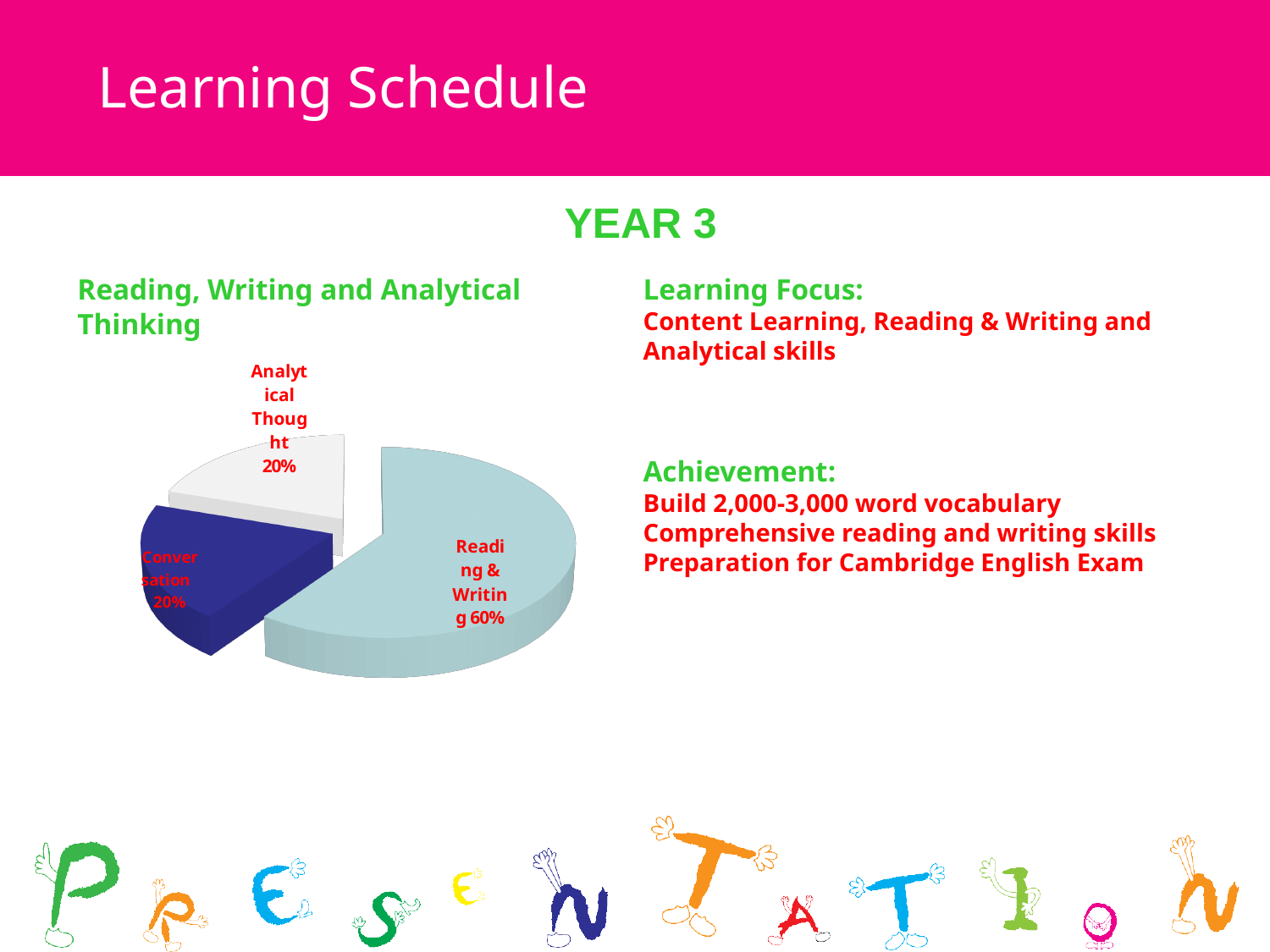
What share of the pie does Reading & Writing take up? 60% What colour is the Conversation slice? Dark blue What percentage does the Reading & Writing slice represent? 60% What kind of chart is shown on the slide? Pie chart Which slice of the pie chart is the largest? Reading & Writing What percentage does the Conversation slice represent? 20% What percentage does the Analytical Thought slice represent? 20% How many slices does the pie chart have? 3 What is the title of the chart? Reading, Writing and Analytical Thinking What is the difference in percentage points between the Reading & Writing slice and the Analytical Thought slice? 40 Which is larger, the Reading & Writing slice or the Conversation slice? Reading & Writing